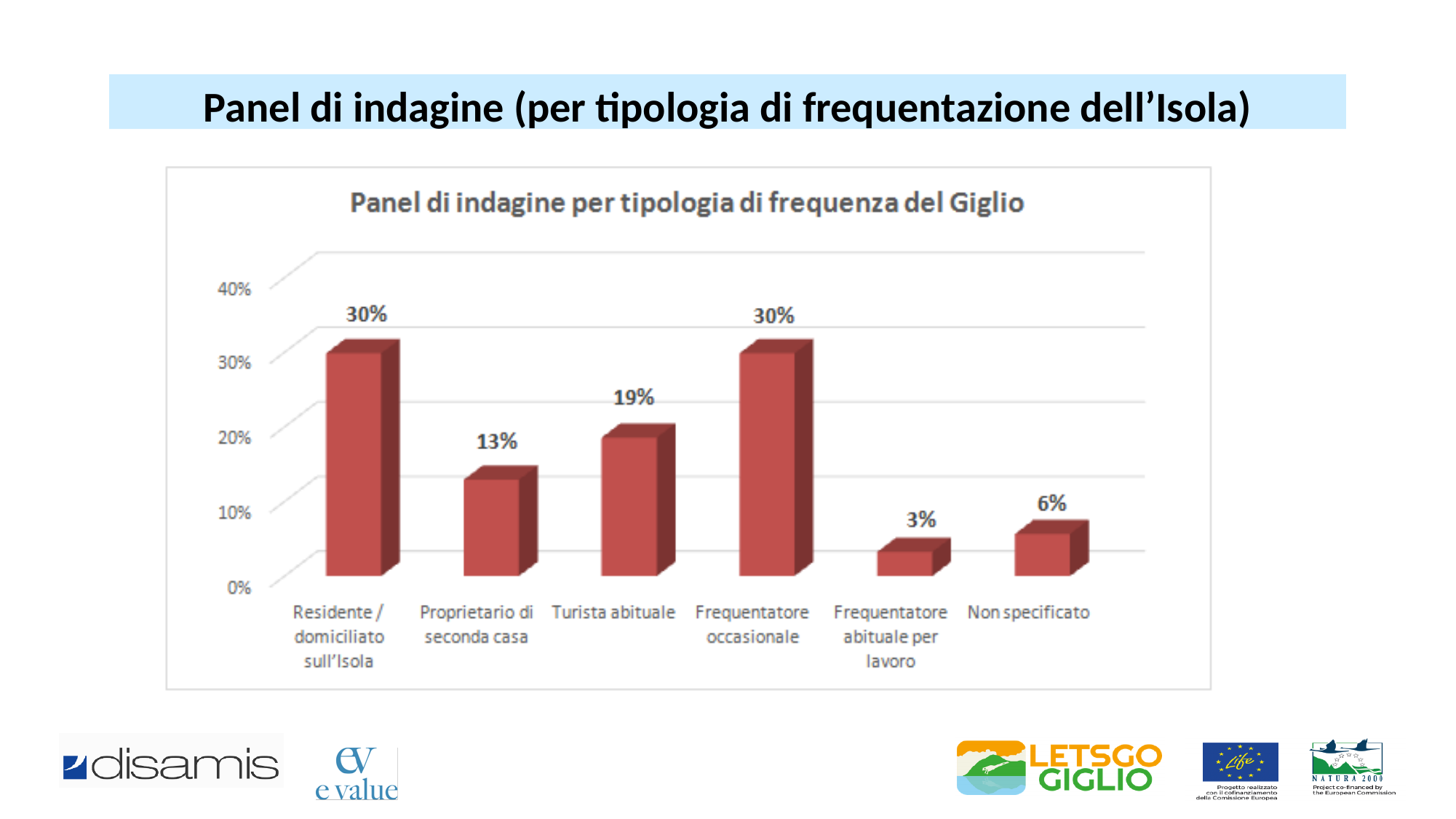
Which category has the lowest value? Frequentatore abituale per lavoro What is the title of the chart? Panel di indagine per tipologia di frequenza del Giglio How many categories are shown on the x axis? 6 What kind of chart is shown? bar chart What is the value for Frequentatore abituale per lavoro? 3% Is the value for Frequentatore occasionale greater or less than 20%? greater What is the value for Non specificato? 6% Which is larger, the value for Turista abituale or the value for Non specificato? Turista abituale What is the value for Proprietario di seconda casa? 13% What is the difference between the values for Turista abituale and Proprietario di seconda casa? 6% What is the value for Turista abituale? 19% What is the difference between the values for Residente / domiciliato sull'Isola and Non specificato? 24%